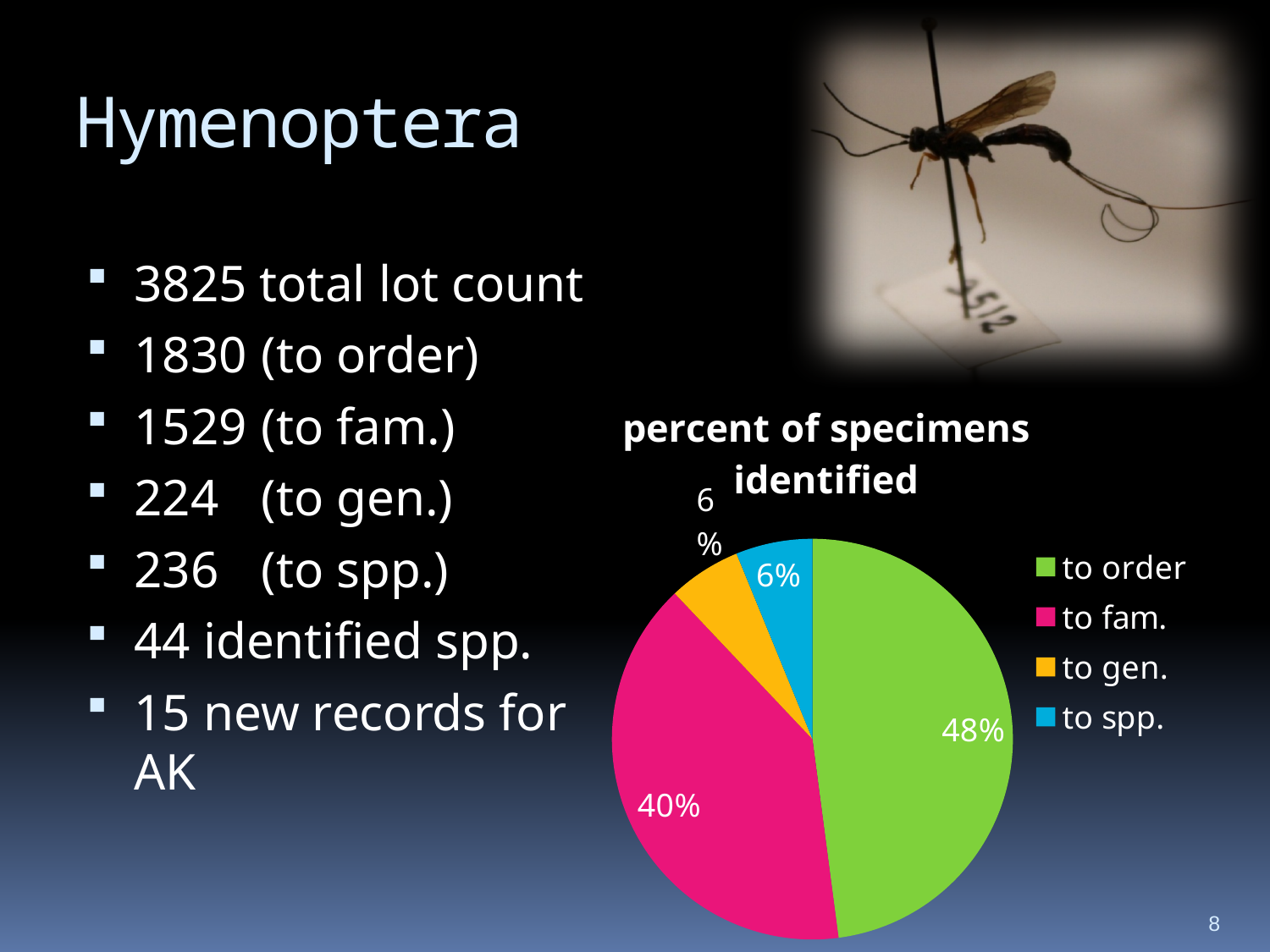
What is the combined share of specimens identified to gen. and to spp.? 12% Which is larger, the share identified to fam. or the share identified to gen.? to fam. Which category has the largest share of the pie? to order How many slices does the pie chart have? 4 What is the difference between the share identified to order and the share identified to fam.? 8% How many entries does the legend list? 4 What is the title of the chart? percent of specimens identified What percentage of specimens were identified to spp.? 6% What percentage of specimens were identified to order? 48% What type of chart is shown on the slide? pie chart What colour is the slice for 'to order'? green What percentage of specimens were identified to fam.? 40%